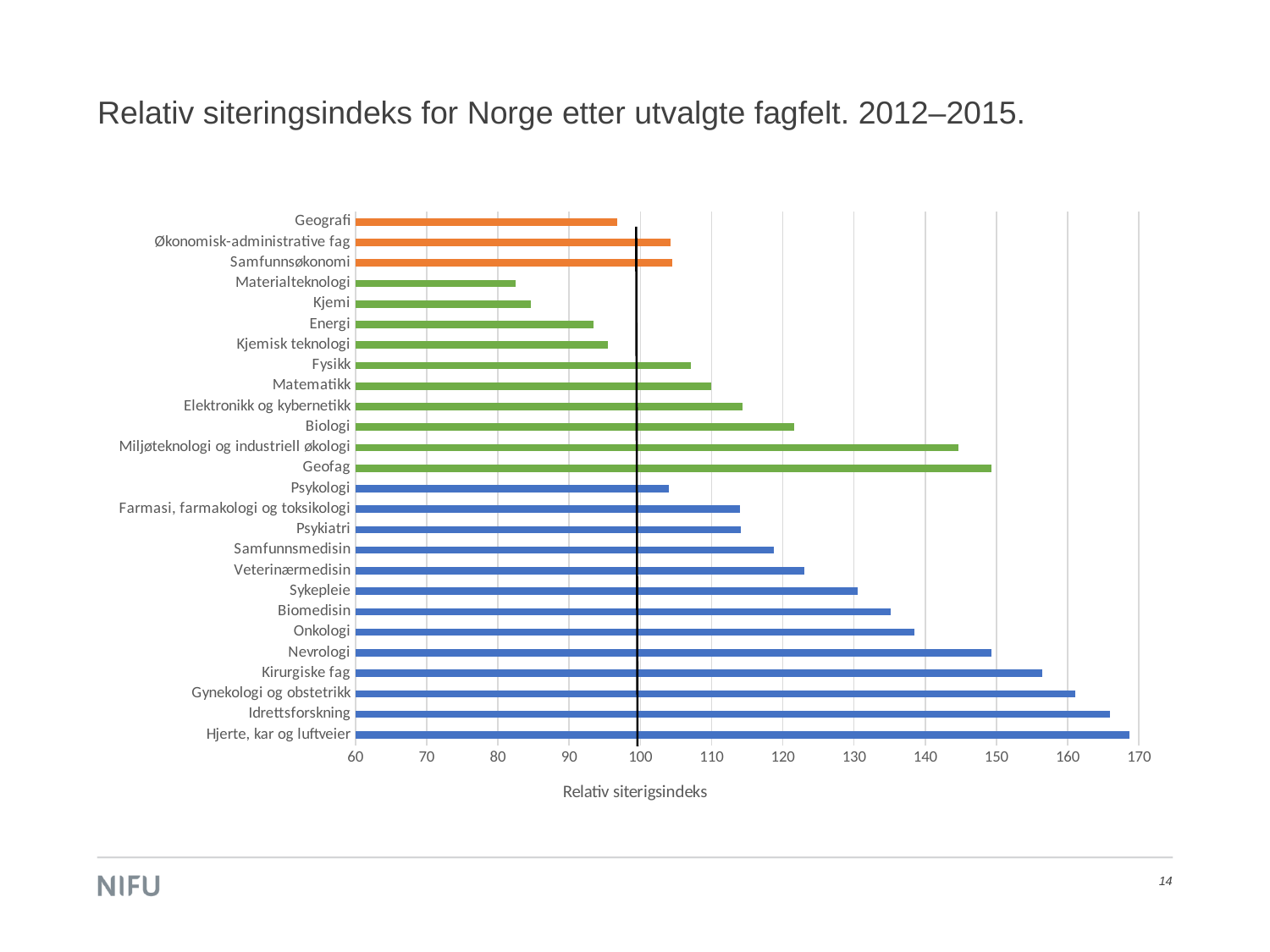
What is the title of the chart? Relativ siteringsindeks for Norge etter utvalgte fagfelt. 2012–2015. Is the value for Geofag greater or less than 140? greater Is the value for Kjemi greater or less than 90? less What kind of chart is shown on the slide? Bar chart What is the label on the horizontal axis? Relativ siterigsindeks Is the value for Geografi greater or less than 100? less Which has the larger value, Geofag or Miljøteknologi og industriell økologi? Geofag Which field has the highest relative citation index? Hjerte, kar og luftveier Which has the larger value, Veterinærmedisin or Samfunnsmedisin? Veterinærmedisin How many fields (categories) are plotted in the chart? 26